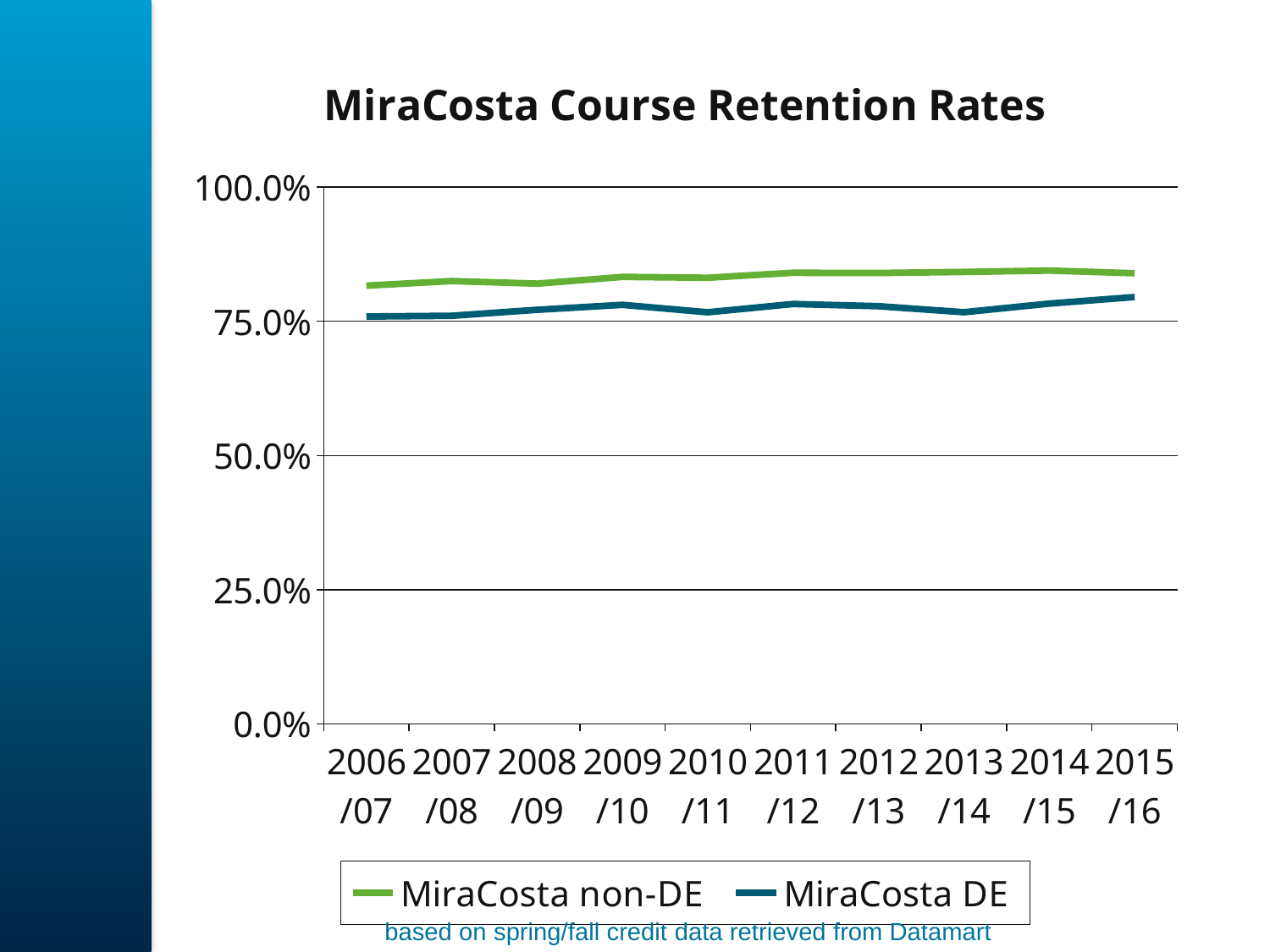
In 2015/16, which series has the higher retention rate, MiraCosta non-DE or MiraCosta DE? MiraCosta non-DE Is the value for MiraCosta DE in 2015/16 greater or less than 75.0%? greater Is the value for MiraCosta non-DE in 2010/11 greater or less than 100.0%? less Is the value for MiraCosta non-DE in 2015/16 greater or less than 75.0%? greater In which year is the MiraCosta DE retention rate highest? 2015/16 What kind of chart is shown on the slide? line chart Which series is plotted with the green line? MiraCosta non-DE How many academic years are plotted along the x axis? 10 What is the title of the chart? MiraCosta Course Retention Rates How many series does the legend list? 2 Does the MiraCosta DE retention rate rise or fall overall from 2006/07 to 2015/16? rise In 2006/07, which series has the lower retention rate, MiraCosta non-DE or MiraCosta DE? MiraCosta DE